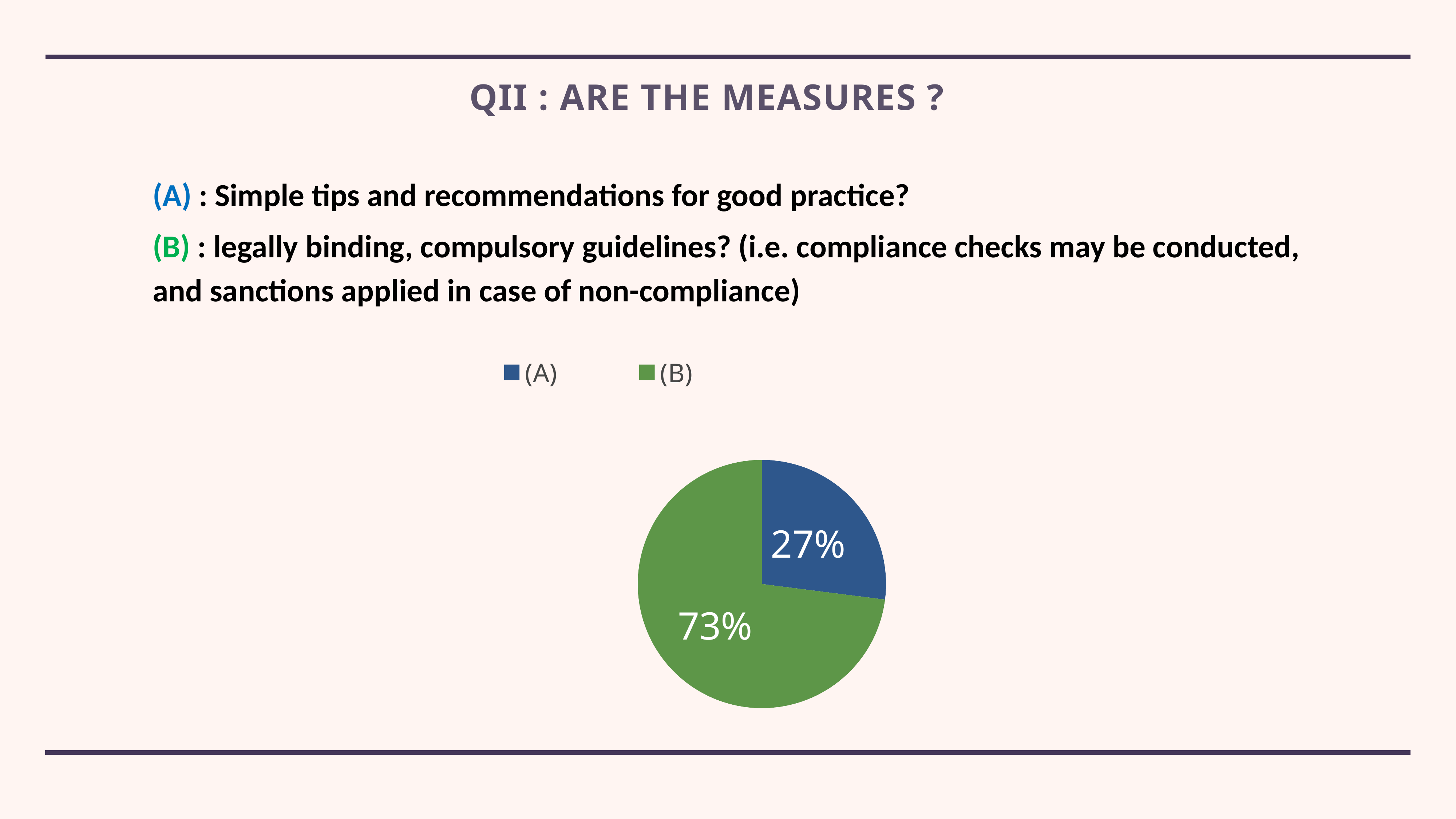
What percentage of the pie is labelled for (A)? 27% What colour is the (A) slice in the pie chart? blue What share of the pie does the (B) slice represent? 73% What is the difference in percentage points between the (B) slice and the (A) slice? 46 How many entries does the legend list? 2 Which slice of the pie is the largest? (B) How many slices does the pie chart have? 2 What colour is the (B) slice in the pie chart? green Which slice of the pie is the smallest? (A) What kind of chart is shown on the slide? pie chart Which is larger, the (A) slice or the (B) slice? (B) What percentage of the pie is labelled for (B)? 73%